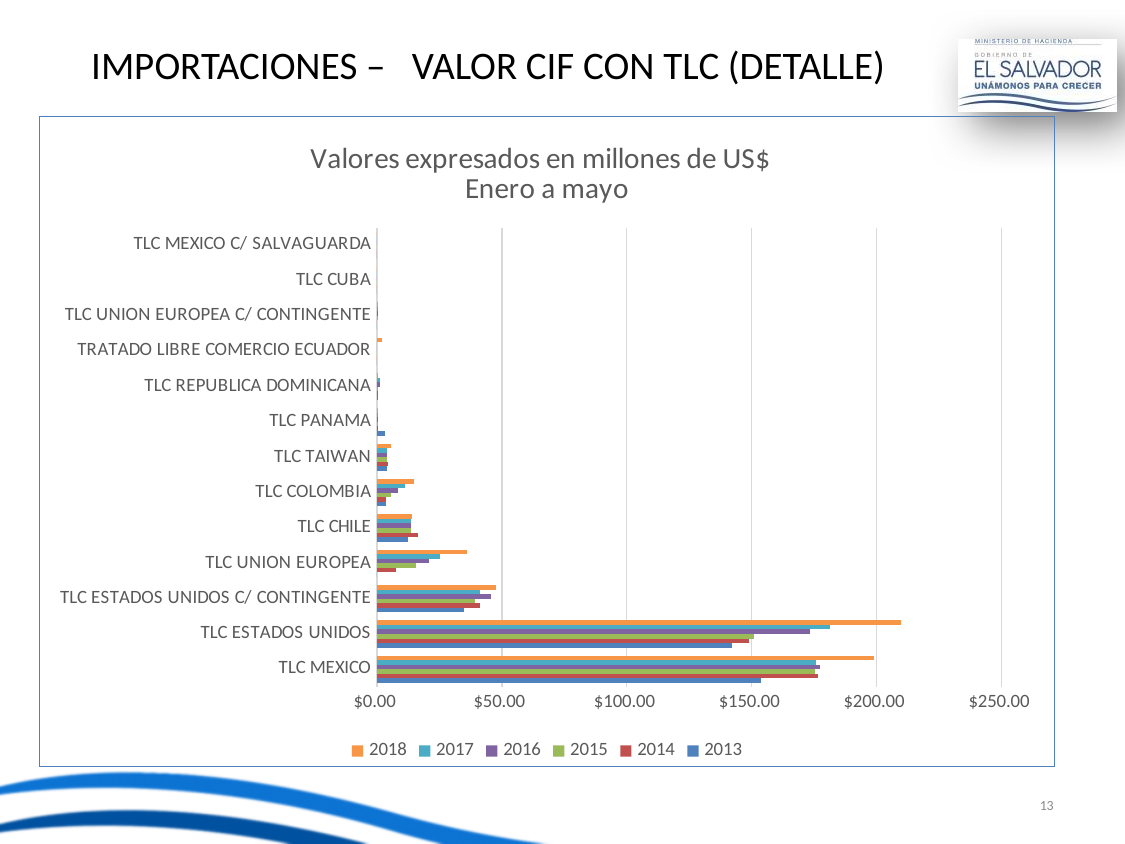
Is the 2018 value for TLC ESTADOS UNIDOS greater or less than $200.00? greater Is the 2018 value for TLC UNION EUROPEA greater or less than $50.00? less Is the 2017 value for TLC ESTADOS UNIDOS greater or less than $150.00? greater What is the title of the chart? Valores expresados en millones de US$ Enero a mayo Which is larger for 2018: TLC UNION EUROPEA or TLC CHILE? TLC UNION EUROPEA What is the highest value shown on the horizontal axis? $250.00 Which year has the longest bar for TLC UNION EUROPEA? 2018 How many trade agreement categories are listed on the vertical axis? 13 For TLC ESTADOS UNIDOS, which is larger: the 2018 value or the 2013 value? 2018 How many series does the legend list? 6 What kind of chart is shown on the slide? bar chart